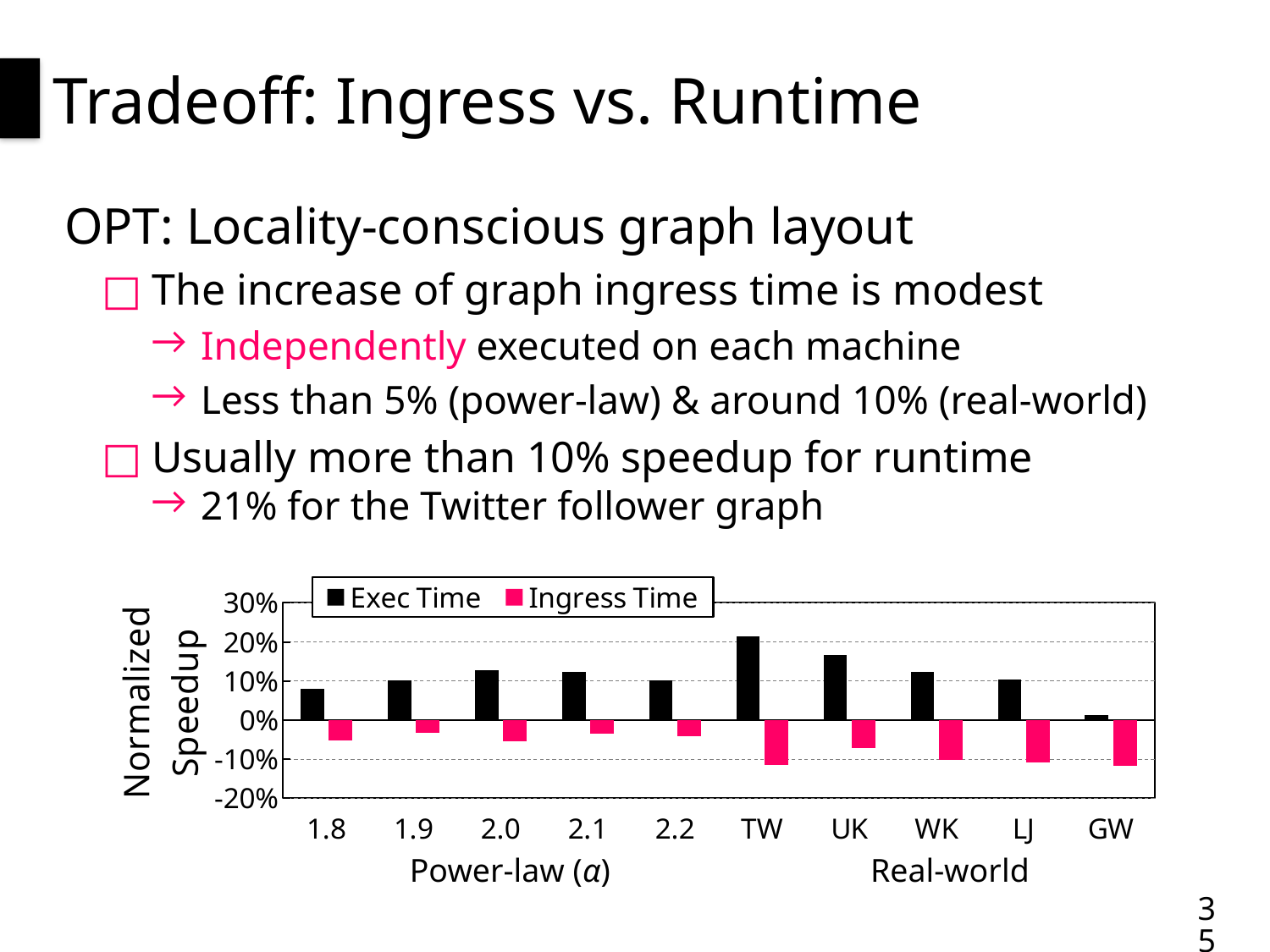
Is the Ingress Time value for 1.8 greater or less than -10%? greater Which is larger, the Exec Time value for LJ or for GW? LJ Which category has the lowest Exec Time speedup? GW Which is larger, the Exec Time value for TW or for UK? TW How many series does the chart's legend list? 2 Is the Exec Time value for TW greater or less than 10%? greater How many categories are shown along the x axis of the chart? 10 What kind of chart is shown on the slide? bar chart Which category has the highest Exec Time speedup? TW What is the label of the chart's vertical axis? Normalized Speedup Which colour represents the Ingress Time series in the chart? pink Is the Exec Time value for GW greater or less than 10%? less